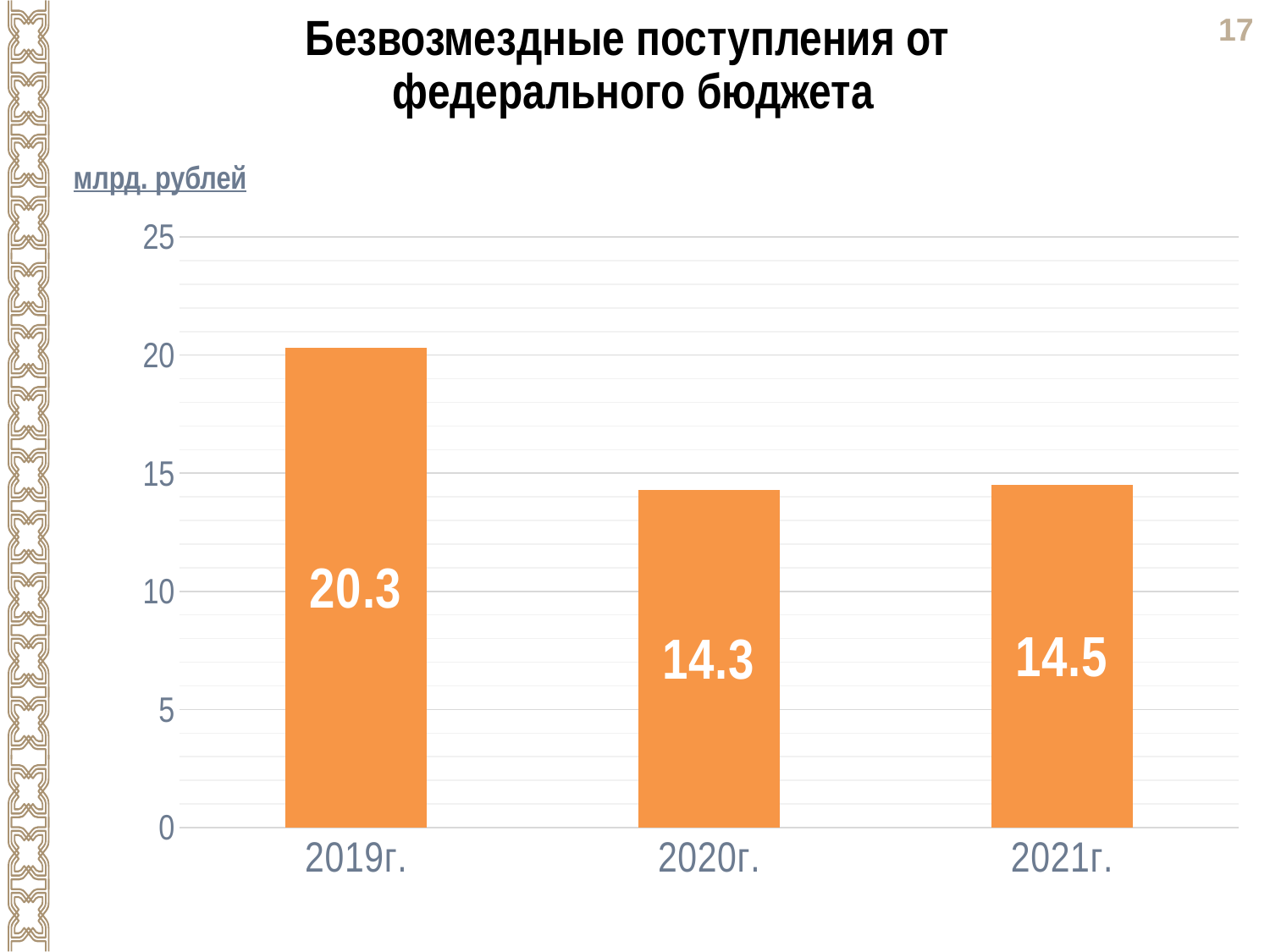
What unit is indicated for the values on the chart? млрд. рублей Is the value for 2020г. greater or less than 15? less How many years are shown on the chart? 3 What is the difference between the values for 2021г. and 2020г.? 0.2 Which year has the highest value? 2019г. What kind of chart is shown on the slide? bar chart Which is larger, the value for 2019г. or the value for 2021г.? 2019г. What is the value for 2020г.? 14.3 Which year has the lowest value? 2020г. What is the difference between the values for 2019г. and 2020г.? 6 What is the value for 2021г.? 14.5 What is the value for 2019г.? 20.3